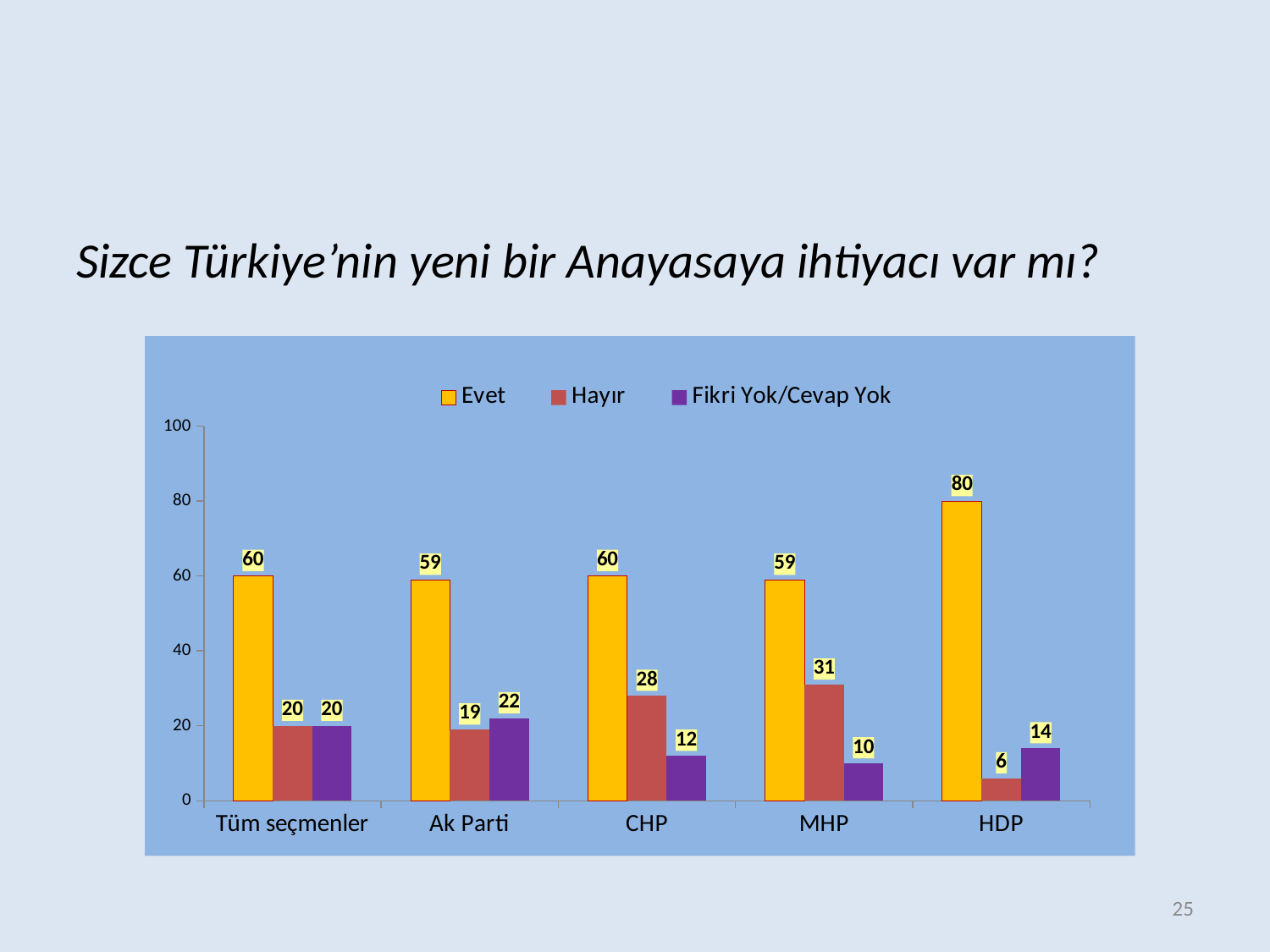
How many categories are shown on the x axis? 5 Which category has the highest Evet value? HDP What is the difference between the Evet value for HDP and the Evet value for Tüm seçmenler? 20 Which is larger, the Hayır value for CHP or the Hayır value for MHP? MHP Which category has the lowest Hayır value? HDP What is the Fikri Yok/Cevap Yok value for Ak Parti? 22 What is the difference between the Hayır and Fikri Yok/Cevap Yok values for CHP? 16 What kind of chart is shown on the slide? Bar chart What is the Hayır value for MHP? 31 What is the title of the slide above the chart? Sizce Türkiye'nin yeni bir Anayasaya ihtiyacı var mı? How many series does the legend list? 3 What is the Evet value for HDP? 80